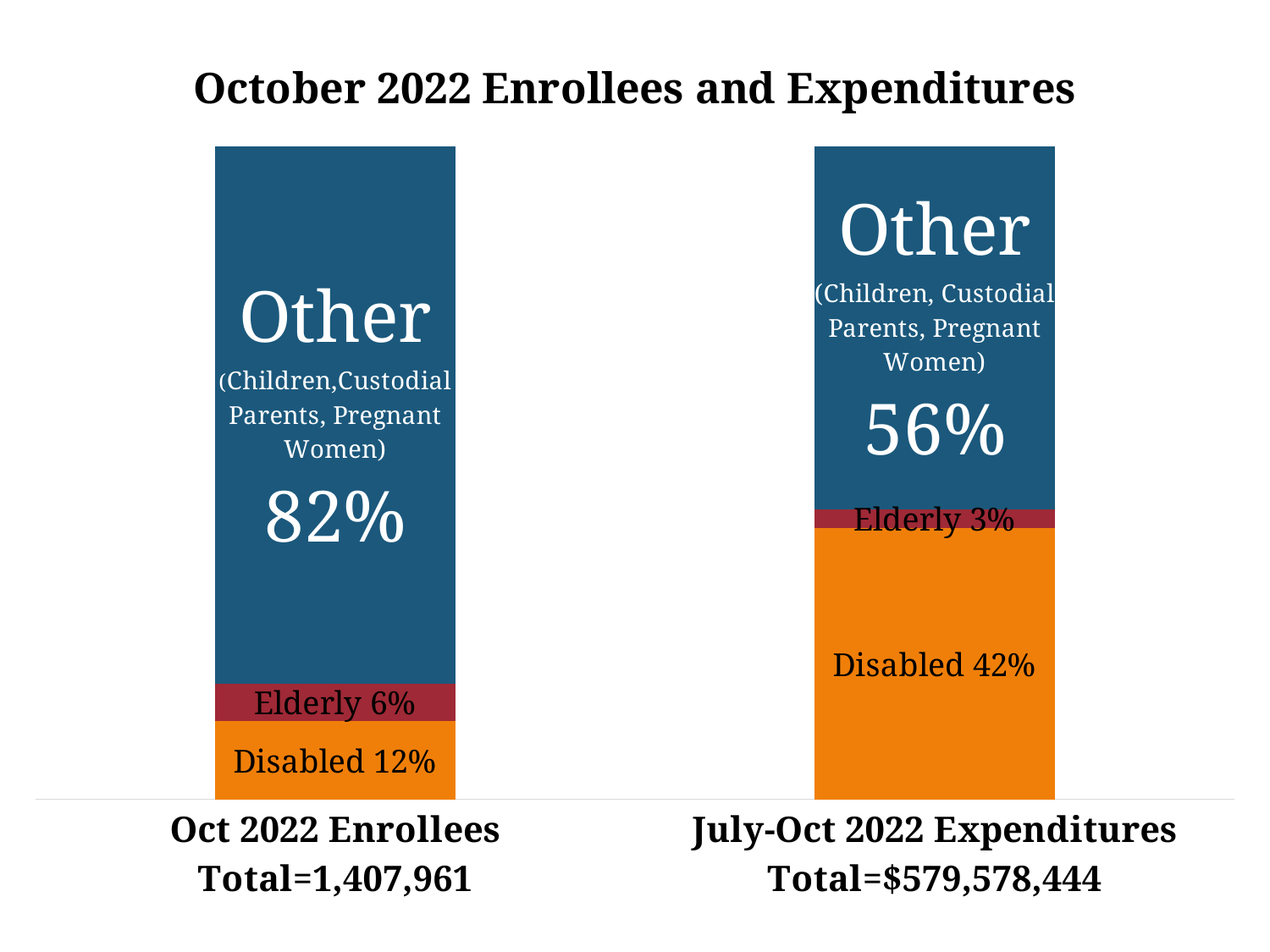
What kind of chart is shown on the slide? Stacked bar chart What percentage of Oct 2022 Enrollees are Elderly? 6% What is the total number of Oct 2022 Enrollees stated on the slide? 1,407,961 Which group has the largest share of Oct 2022 Enrollees? Other (Children, Custodial Parents, Pregnant Women) What is the difference between the Disabled share of July-Oct 2022 Expenditures and the Disabled share of Oct 2022 Enrollees? 30 percentage points What percentage of July-Oct 2022 Expenditures went to the Elderly group? 3% What percentage of Oct 2022 Enrollees are Disabled? 12% Is the Disabled share larger for Oct 2022 Enrollees or for July-Oct 2022 Expenditures? July-Oct 2022 Expenditures How many stacked bars are shown on the chart? 2 How many groups make up each stacked bar? 3 Which group has the smallest share of July-Oct 2022 Expenditures? Elderly What share of July-Oct 2022 Expenditures is for the Other (Children, Custodial Parents, Pregnant Women) group? 56%